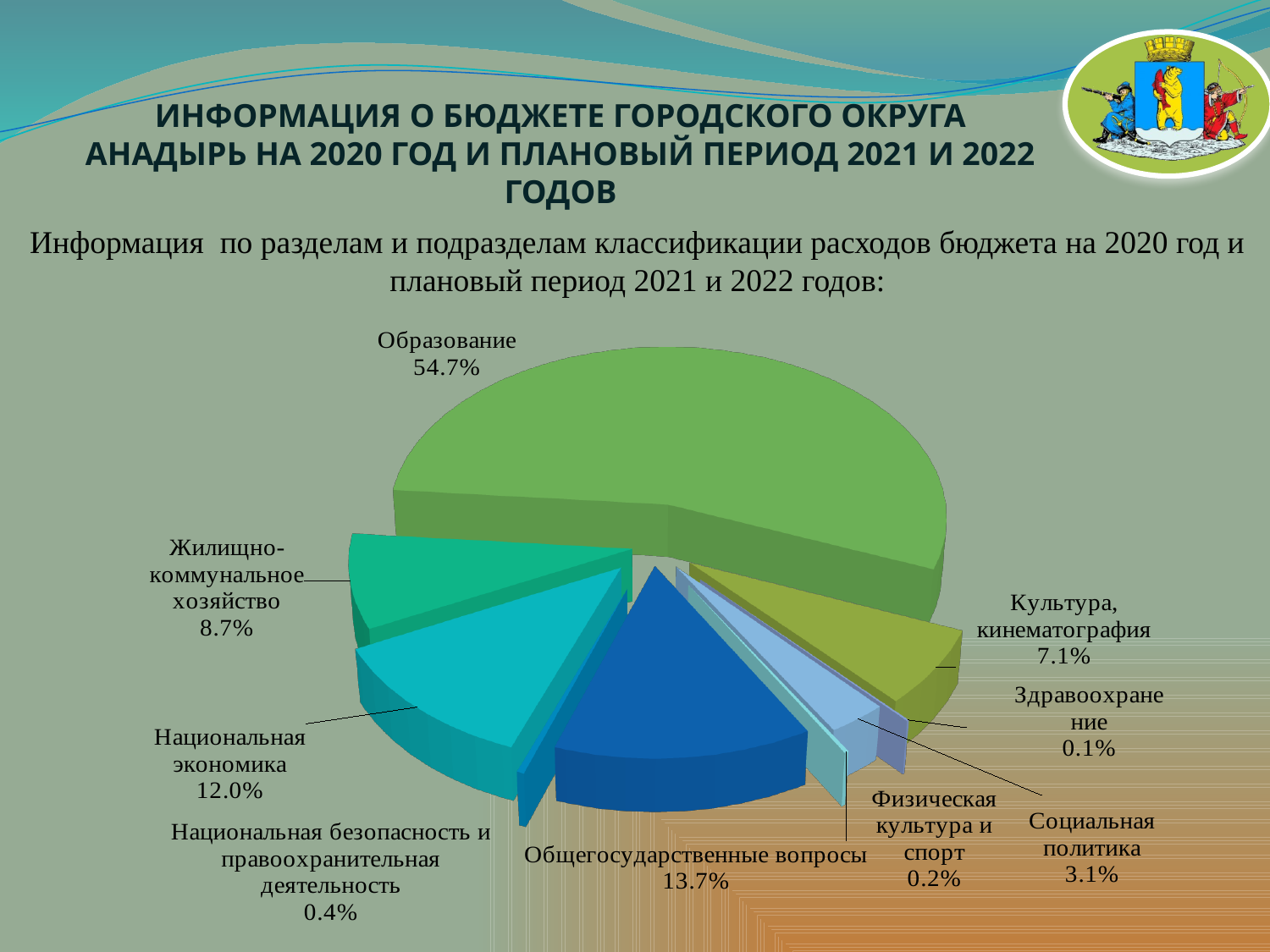
What is the value shown for Жилищно-коммунальное хозяйство? 8.7% What is the difference between the shares of Общегосударственные вопросы and Национальная экономика? 1.7% What is the value shown for Общегосударственные вопросы? 13.7% What kind of chart is shown on the slide? pie chart What is the value shown for Социальная политика? 3.1% Which is larger: the share of Культура, кинематография or the share of Жилищно-коммунальное хозяйство? Жилищно-коммунальное хозяйство What share of the pie does Образование have? 54.7% What is the difference between the shares of Социальная политика and Национальная безопасность и правоохранительная деятельность? 2.7% What is the value shown for Национальная экономика? 12.0% How many slices does the pie chart have? 9 Which category has the largest share of the pie? Образование Which category has the smallest share of the pie? Здравоохранение